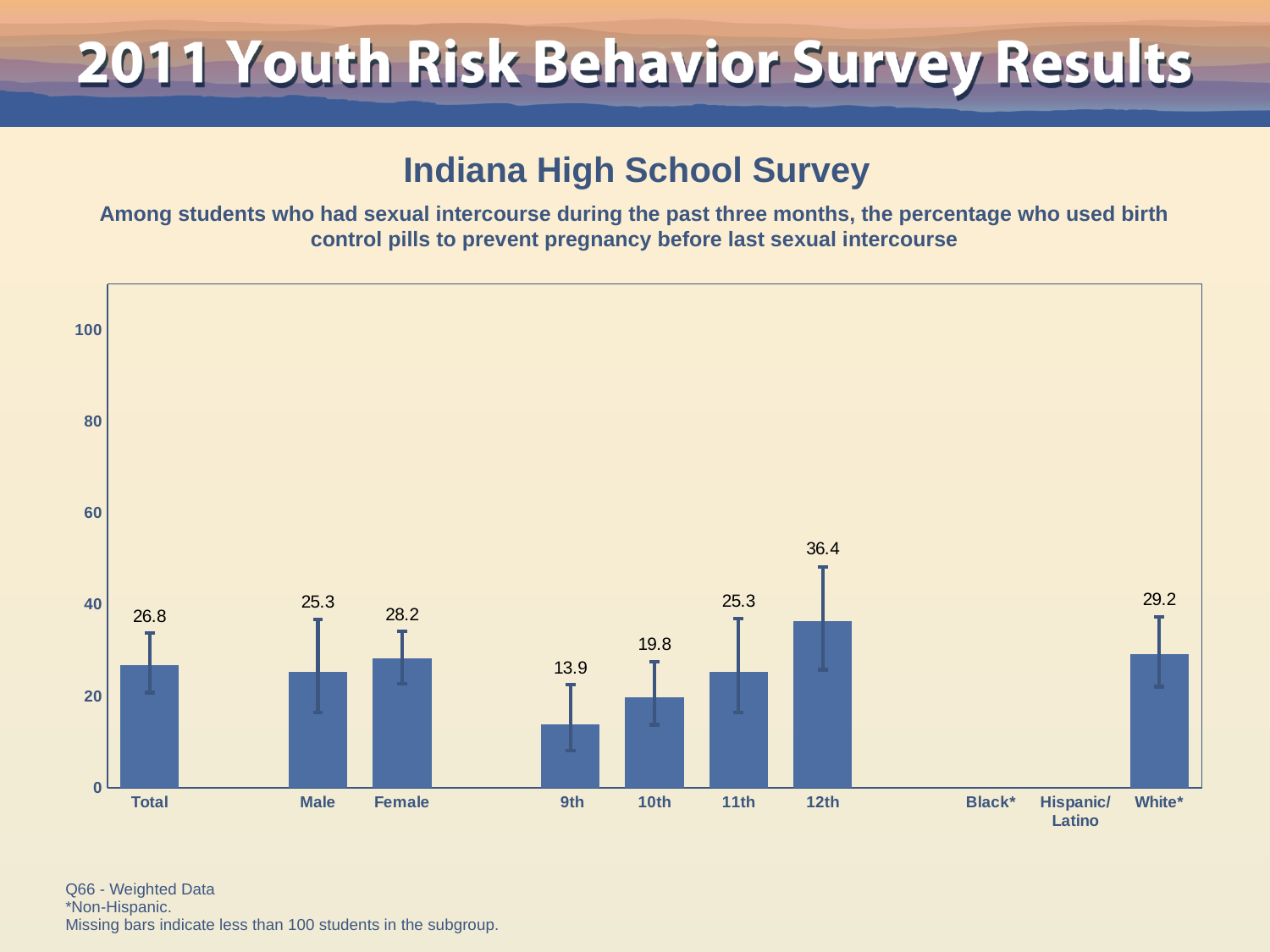
What is the value for 12th grade? 36.4 What kind of chart is shown? bar chart Do the values rise or fall from 9th to 12th grade? rise How many categories have bars plotted? 8 Is the value for 12th greater or less than 40? less Which categories have no bar shown? Black* and Hispanic/Latino What is the value for Total? 26.8 What is the difference between the Female and Male values? 2.9 Which is larger, the value for 10th or the value for 11th? 11th Which category has the lowest value among those with bars? 9th What is the value for White*? 29.2 Which category has the highest value? 12th